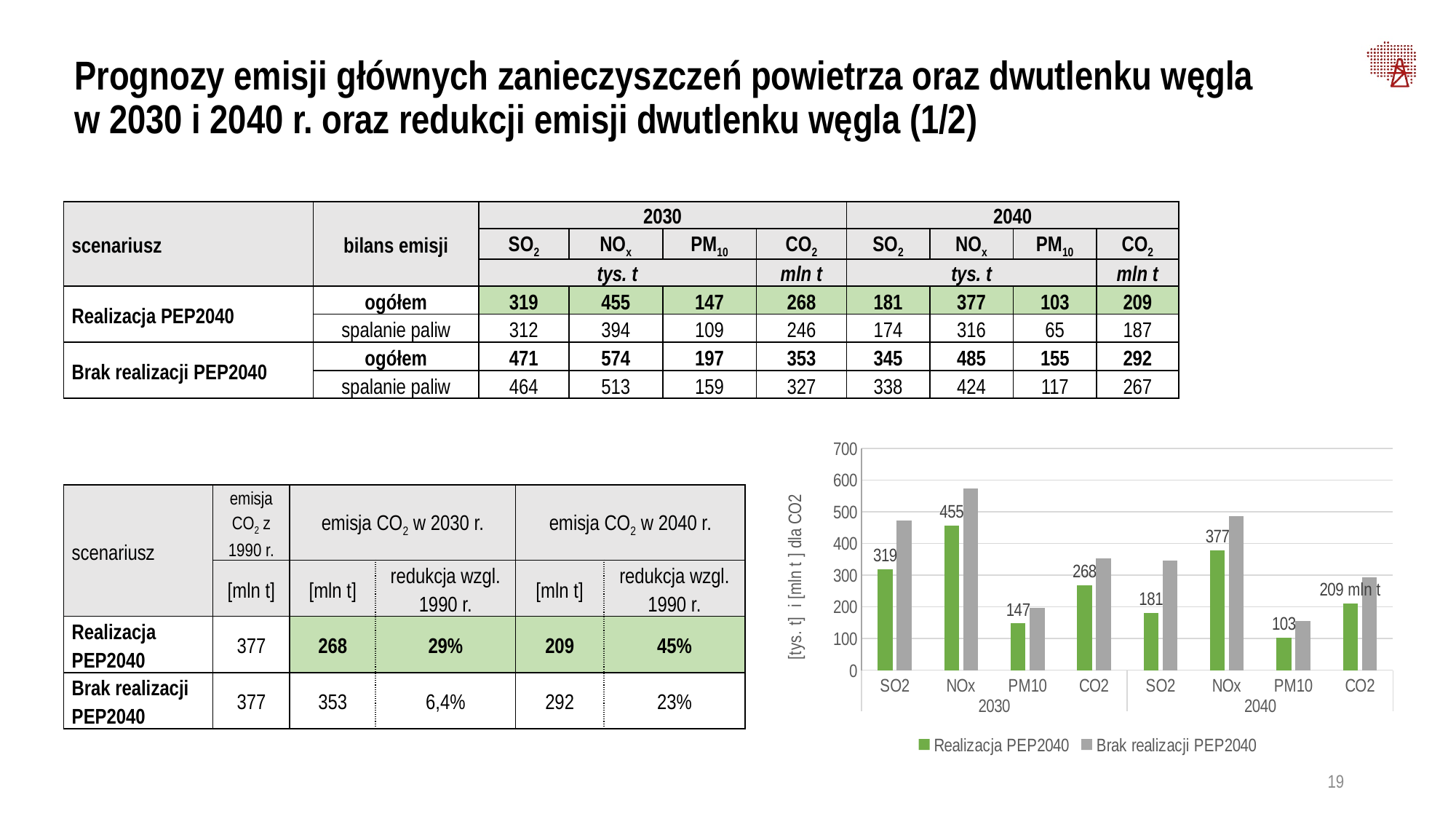
In the bar chart, what is the value for Realizacja PEP2040 for PM10 in 2040? 103 In the bar chart, is the Brak realizacji PEP2040 value for PM10 in 2030 greater or less than 300? less In the bar chart, what is the difference between the Realizacja PEP2040 values for SO2 in 2030 and SO2 in 2040? 138 In the bar chart, for SO2 in 2030, which series has the larger value: Realizacja PEP2040 or Brak realizacji PEP2040? Brak realizacji PEP2040 In the bar chart, what is the value for Realizacja PEP2040 for NOx in 2030? 455 In the bar chart, which category has the lowest Realizacja PEP2040 value? PM10 in 2040 In the bar chart, is the Brak realizacji PEP2040 value for NOx in 2030 greater or less than 500? greater In the bar chart, which category has the highest Realizacja PEP2040 value? NOx in 2030 How many series does the legend of the bar chart list? 2 What kind of chart is shown on the slide? bar chart In the bar chart, is the Realizacja PEP2040 value for NOx larger in 2030 or in 2040? 2030 How many categories are shown on the x axis of the bar chart? 8